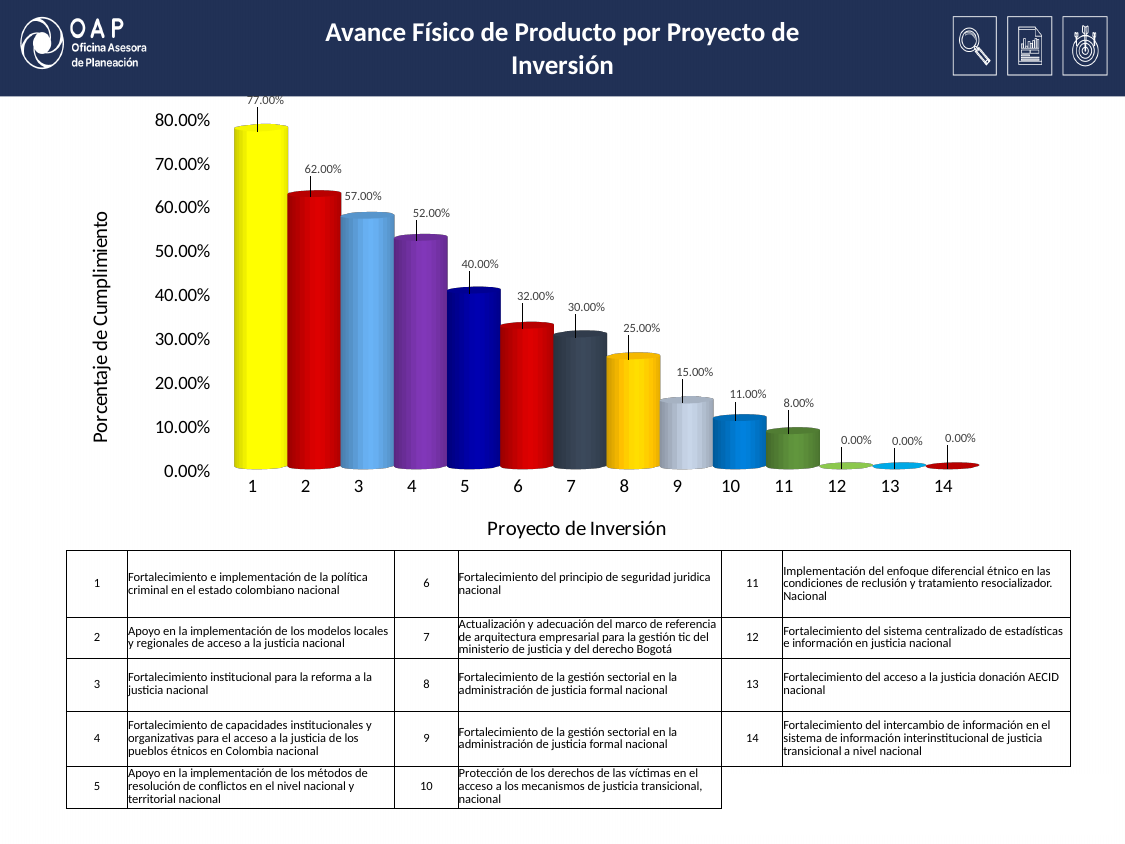
How many Proyectos de Inversión are shown on the x axis of the chart? 14 Which Proyecto de Inversión has the highest Porcentaje de Cumplimiento? 1 Which is larger, the value for Proyecto de Inversión 6 or Proyecto de Inversión 10? Proyecto de Inversión 6 What kind of chart is shown on the slide? bar chart What is the value for Proyecto de Inversión 9? 15.00% What is the difference between the values for Proyecto de Inversión 1 and Proyecto de Inversión 8? 52.00% What is the difference between the values for Proyecto de Inversión 2 and Proyecto de Inversión 3? 5.00% What is the value for Proyecto de Inversión 1? 77.00% What is the title of the chart on the slide? Avance Físico de Producto por Proyecto de Inversión Do the values rise or fall from Proyecto de Inversión 1 to Proyecto de Inversión 14? fall What is the value for Proyecto de Inversión 5? 40.00% Is the value for Proyecto de Inversión 4 greater or less than 50.00%? greater